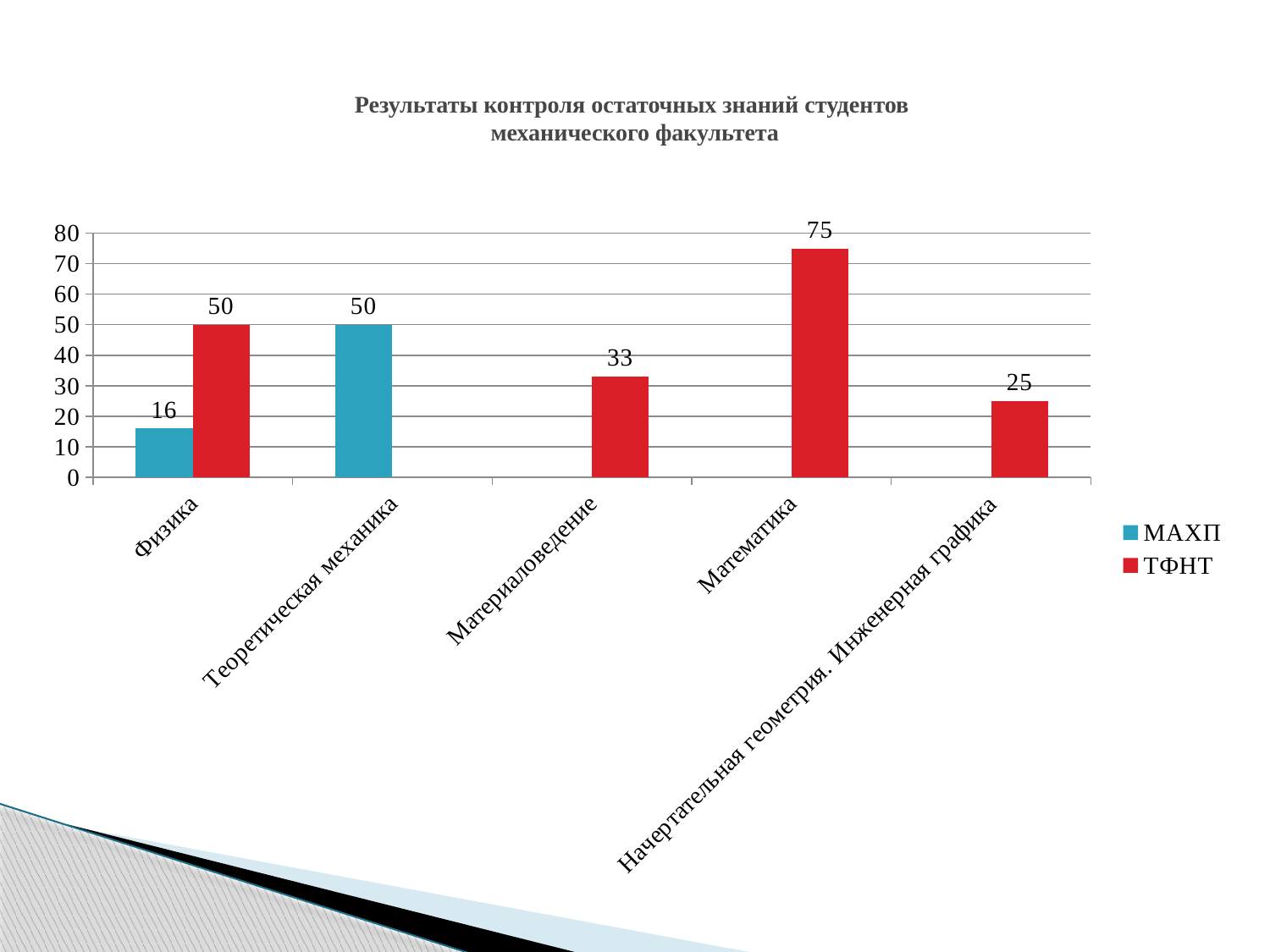
What is the title of the chart? Результаты контроля остаточных знаний студентов механического факультета What is the difference between the ТФНТ and МАХП values in Физика? 34 How many series does the legend list? 2 What is the value for ТФНТ in Математика? 75 How many categories are shown on the x axis? 5 Which is larger in Физика: the МАХП value or the ТФНТ value? ТФНТ What is the value for МАХП in Физика? 16 What is the value for МАХП in Теоретическая механика? 50 What is the value for ТФНТ in Материаловедение? 33 Which category has the highest ТФНТ value? Математика Which category has the lowest ТФНТ value? Начертательная геометрия. Инженерная графика What kind of chart is shown on the slide? bar chart